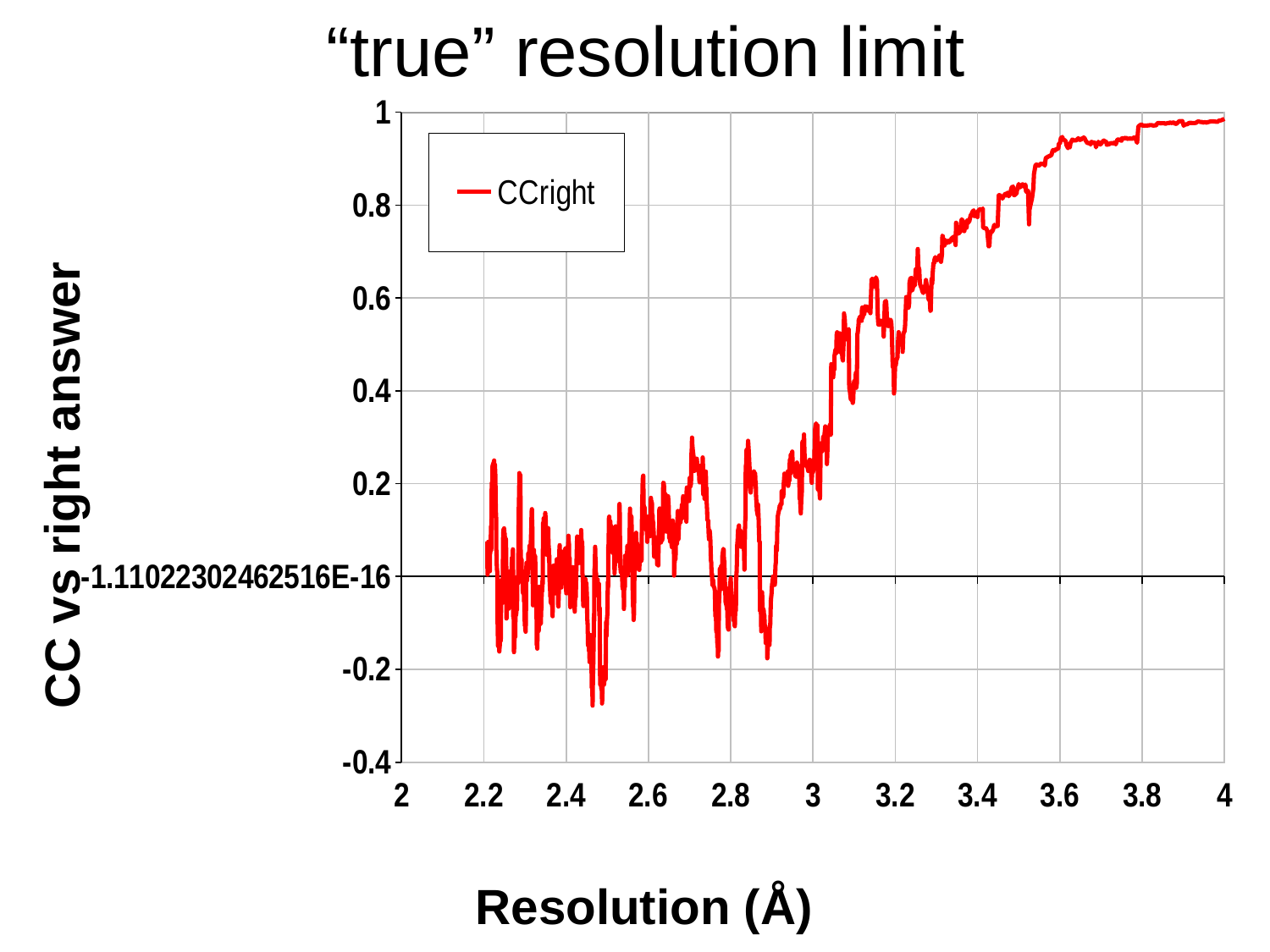
Is the CCright value at a resolution of 2.8 Å greater or less than 0.2? less Is the CCright value at a resolution of 3 Å greater or less than 0.4? less What kind of chart is shown on the slide? line chart What is the name of the series shown in the legend? CCright Is the CCright value at a resolution of 3.6 Å greater or less than 0.8? greater Overall, does the CCright value rise or fall as Resolution increases from 2.2 to 4 Å? rise How many series does the legend list? 1 Which of the two resolutions, 2.6 Å or 3.4 Å, has the larger CCright value? 3.4 Å What is the label of the x axis? Resolution (Å)